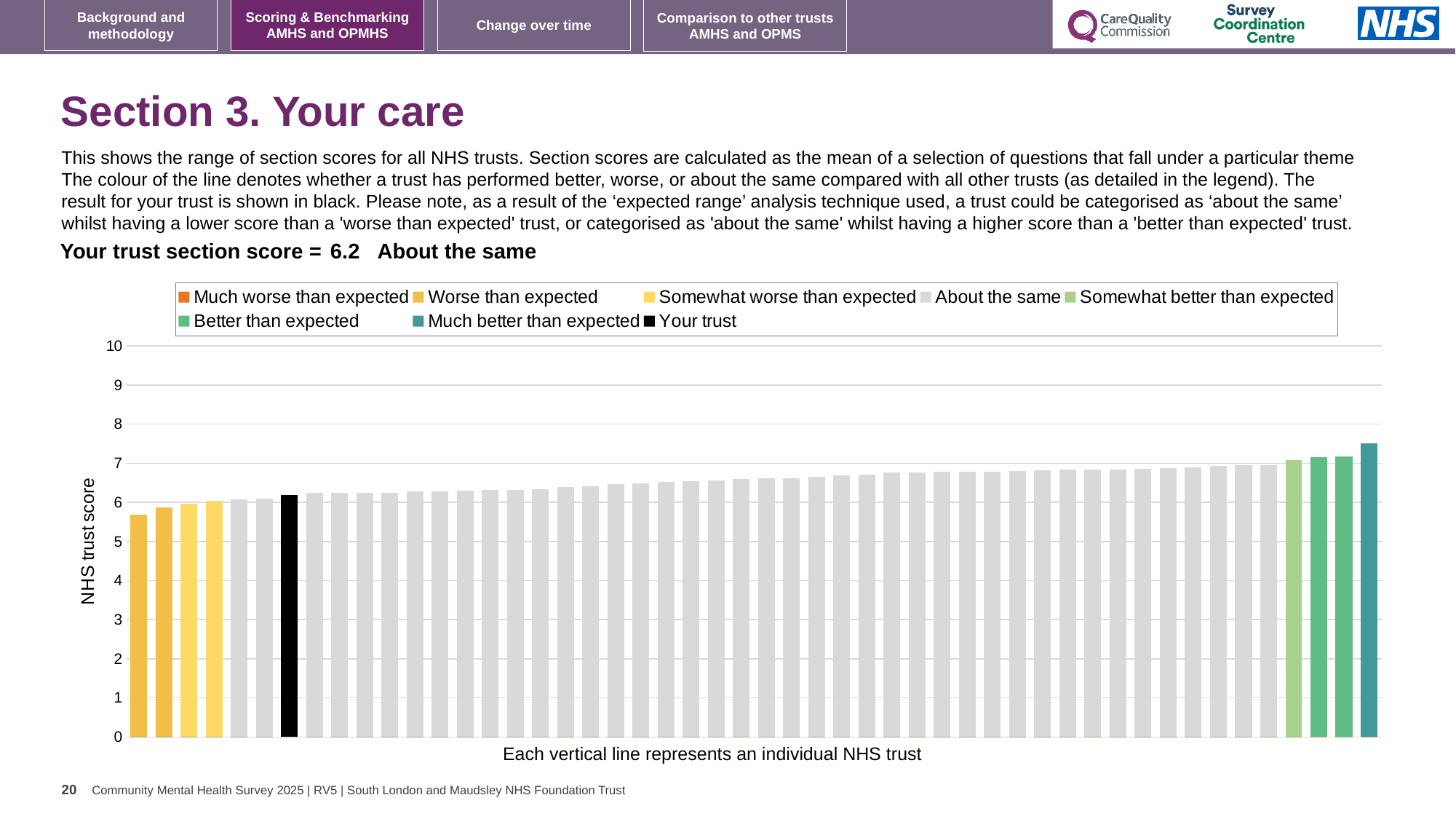
Is the value of the shortest bar greater or less than 6? less What colour is the bar representing your trust? black Is the value for your trust greater or less than 5? greater How many entries does the chart legend list? 8 What is the label on the vertical axis of the chart? NHS trust score Is the value for your trust greater or less than 7? less What is the section score for your trust shown on the slide? 6.2 Do the bar values rise or fall from left to right along the x axis? rise What kind of chart is shown on the slide? bar chart How many bars are coloured as 'Much better than expected'? 1 Which category is your trust placed in for this section? About the same